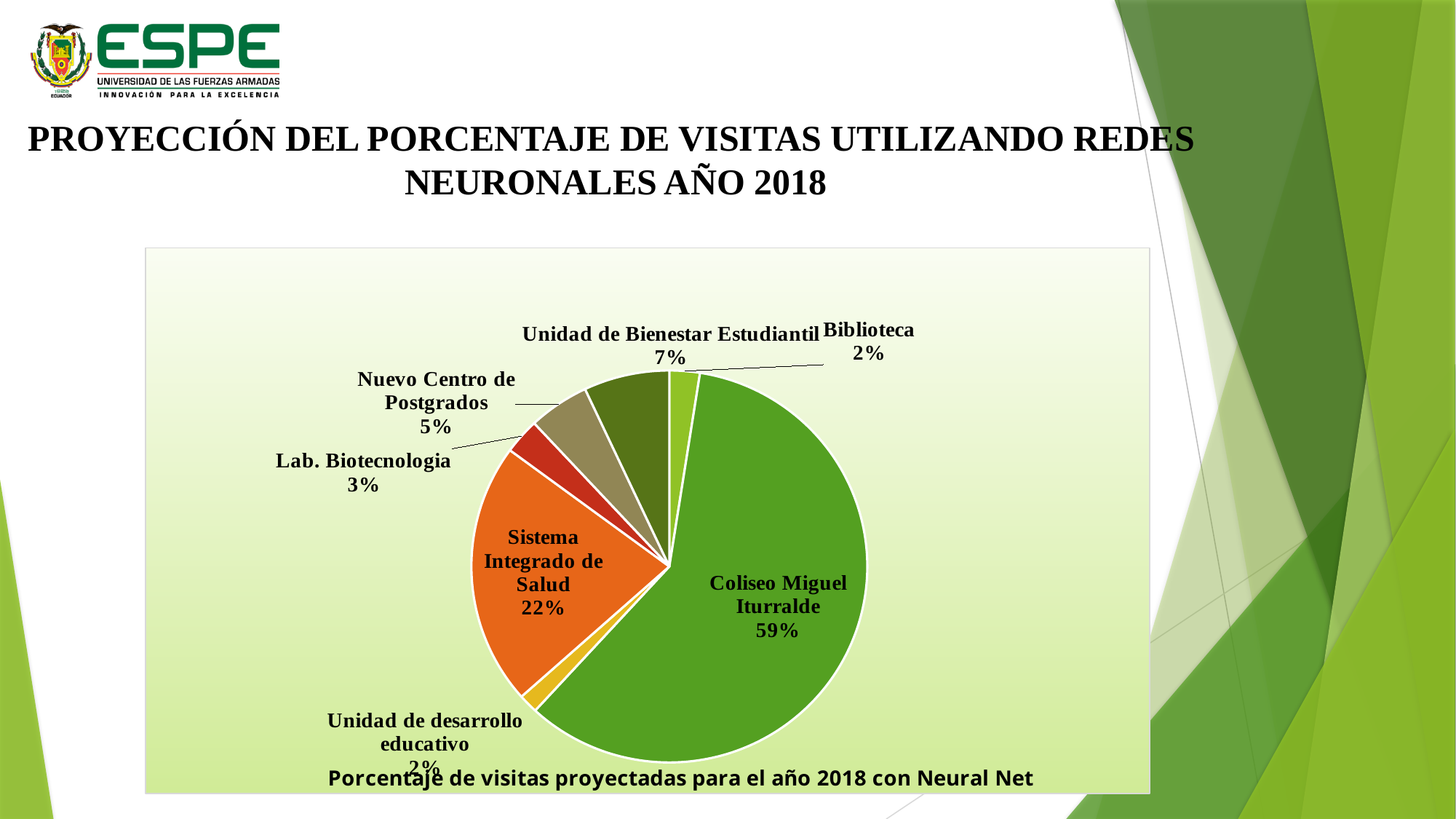
What is the share for Biblioteca? 2% What is the share for Coliseo Miguel Iturralde? 59% What type of chart is shown on the slide? pie chart What is the share for Lab. Biotecnologia? 3% Which category has the largest slice of the pie? Coliseo Miguel Iturralde Which is larger, the share for Unidad de Bienestar Estudiantil or the share for Nuevo Centro de Postgrados? Unidad de Bienestar Estudiantil What is the share for Unidad de Bienestar Estudiantil? 7% What is the share for Sistema Integrado de Salud? 22% What is the share for Nuevo Centro de Postgrados? 5% What is the title of the chart? Porcentaje de visitas proyectadas para el año 2018 con Neural Net What is the difference in percentage points between Coliseo Miguel Iturralde and Sistema Integrado de Salud? 37 How many slices does the pie chart have? 7